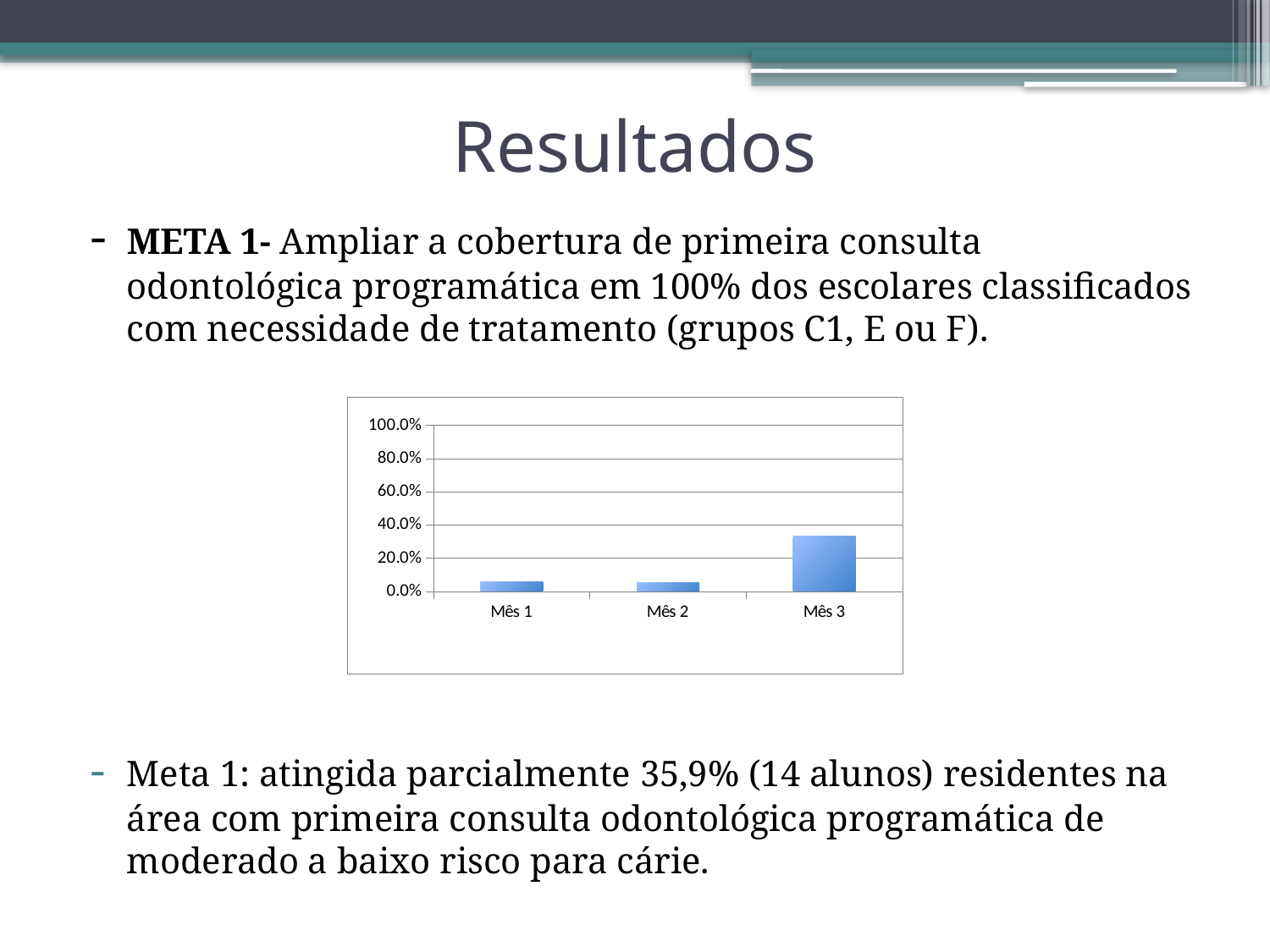
Is the value for Mês 3 greater or less than 20.0%? greater Is the value for Mês 1 greater or less than 20.0%? less Which is larger, the value for Mês 1 or the value for Mês 3? Mês 3 What is the highest value labelled on the y axis of the chart? 100.0% What is the label of the first category on the x axis? Mês 1 What kind of chart is shown on the slide? bar chart How many categories are plotted on the x axis of the chart? 3 Which is larger, the value for Mês 2 or the value for Mês 3? Mês 3 Does the value rise or fall from Mês 2 to Mês 3? rise Which category has the highest value in the chart? Mês 3 Is the value for Mês 3 greater or less than 40.0%? less